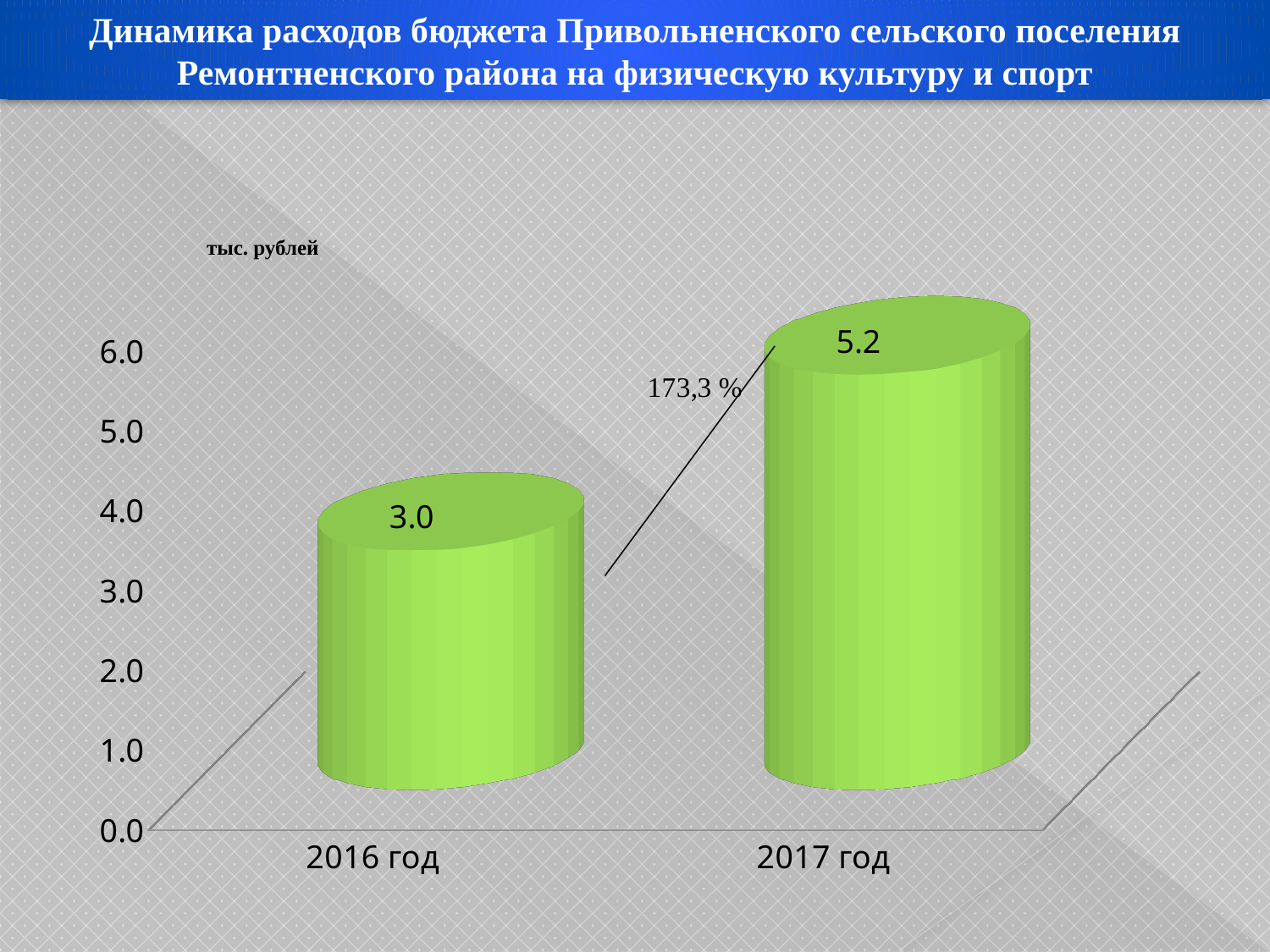
What kind of chart is shown on the slide? bar chart How many categories are shown on the x axis? 2 What is the difference between the values for 2017 год and 2016 год? 2.2 Which is larger, the value for 2016 год or 2017 год? 2017 год What unit is indicated above the chart? тыс. рублей Which year has the highest value? 2017 год Is the value for 2017 год greater or less than 4.0? greater What is the value for 2017 год? 5.2 What percentage is printed between the two bars? 173,3 % What is the value for 2016 год? 3.0 Which year has the lowest value? 2016 год Do the values rise or fall from 2016 год to 2017 год? rise